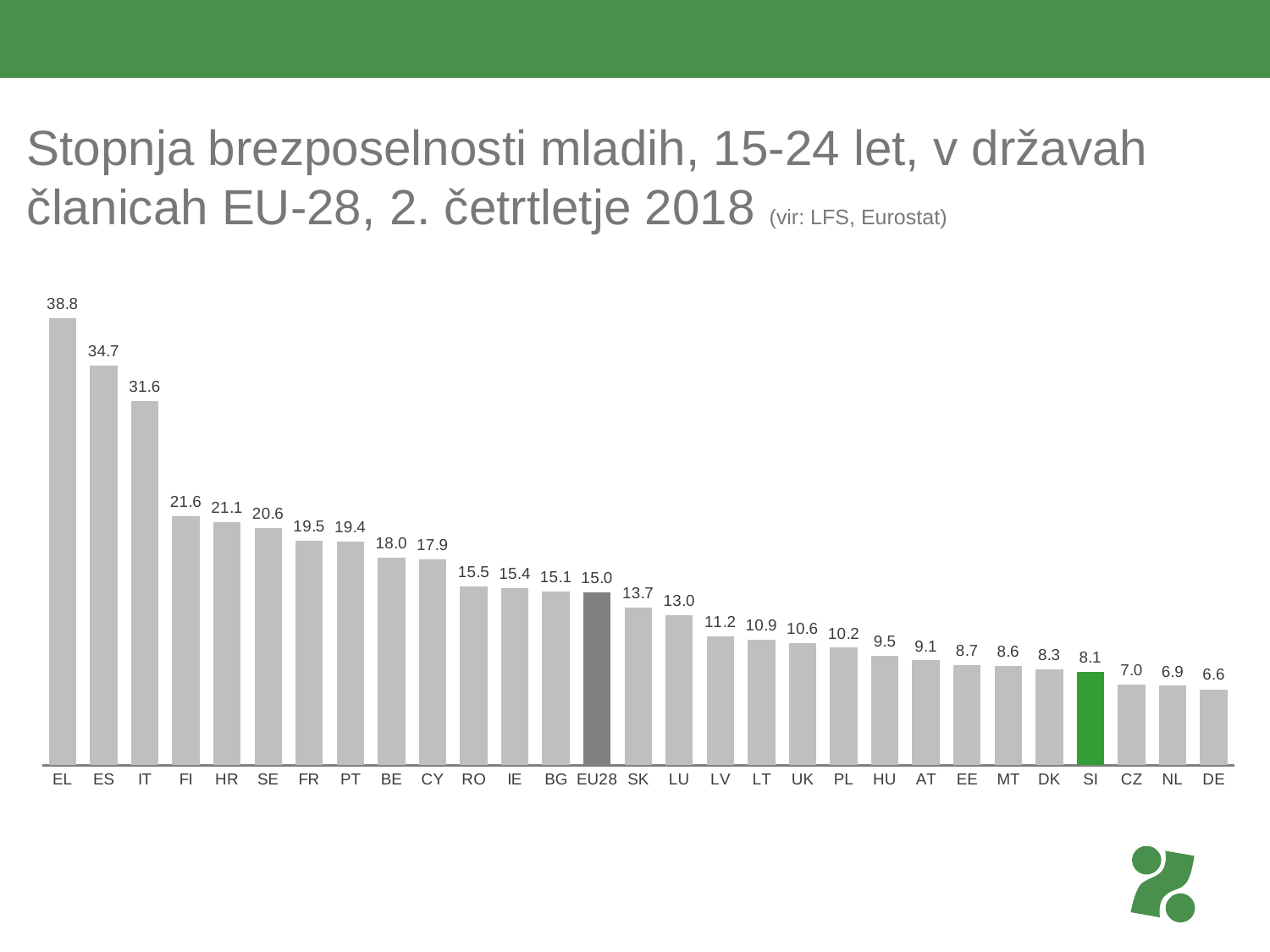
Do the values rise or fall from left to right along the x axis? Fall Which country has the highest youth unemployment rate on the chart? EL Which has a higher value, SK or LU? SK What is the difference between the values for EL and ES? 4.1 What type of chart is shown on the slide? Bar chart Which has a higher value, IT or FI? IT What is the value shown for FR? 19.5 What value is shown for EU28? 15.0 Which country has the lowest youth unemployment rate on the chart? DE What is the youth unemployment rate shown for SI? 8.1 What is the difference between the value for EU28 and the value for SI? 6.9 How many bars are plotted on the chart? 29